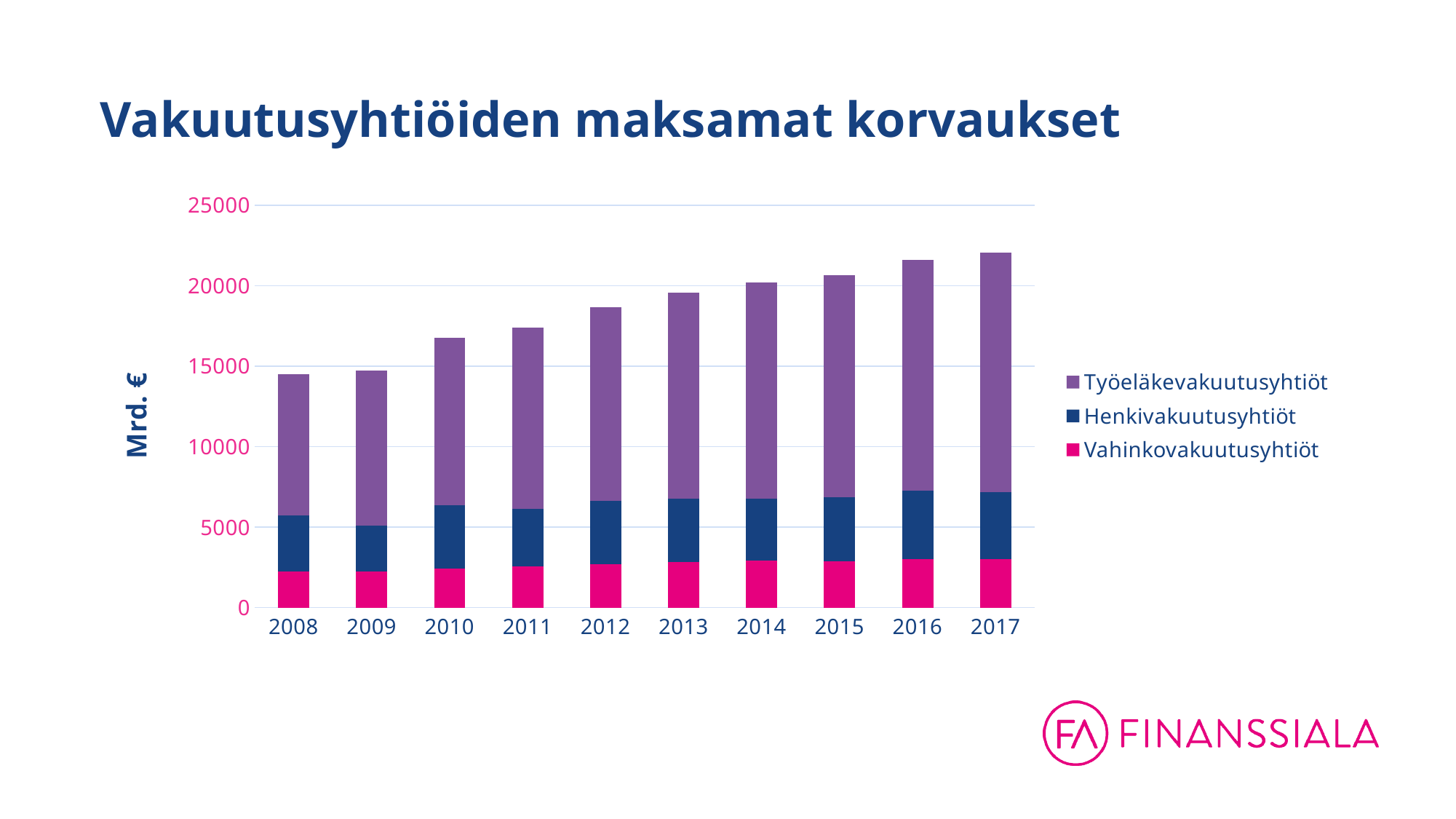
Which year has the lowest total bar? 2008 Is the total value for 2010 greater or less than 15000? greater How many series does the legend list? 3 What is the title of the chart? Vakuutusyhtiöiden maksamat korvaukset Which year has the highest total bar? 2017 How many years are shown on the x axis of the chart? 10 Is the total value for 2008 greater or less than 15000? less Do the total bar heights rise or fall from 2008 to 2017? rise Is the total value for 2012 greater or less than 20000? less Which year has a larger total bar, 2008 or 2017? 2017 What kind of chart is shown on the slide? stacked bar chart